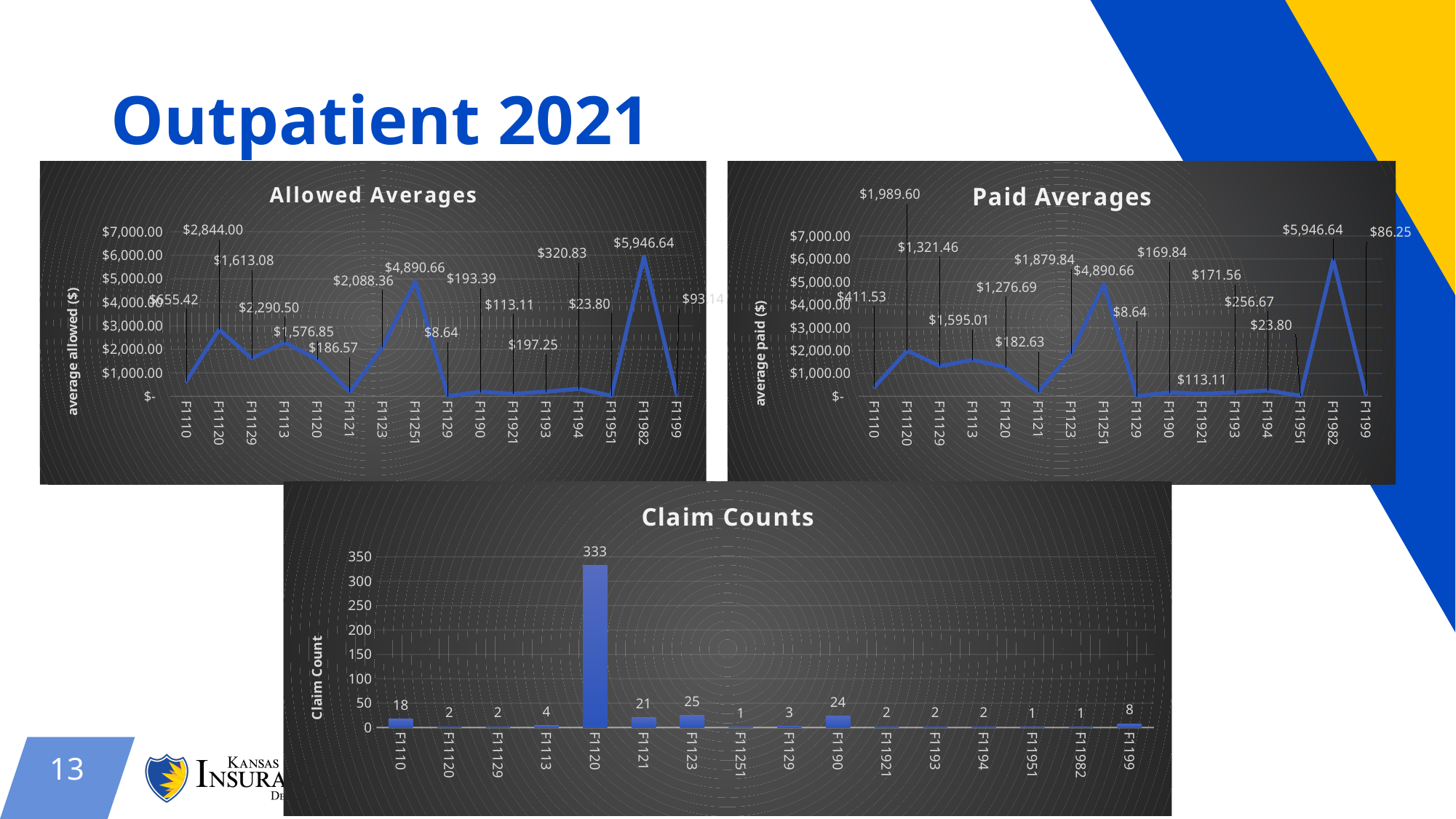
In the Claim Counts chart, what is the difference between the claim counts for F1121 and F1110? 3 How many categories are shown on the x axis of the Claim Counts chart? 16 What kind of chart is the Allowed Averages chart? line chart In the Paid Averages chart, which is larger, the value for F11251 or the value for F11982? F11982 In the Paid Averages chart, what is the average paid amount for F11120? $1,989.60 In the Allowed Averages chart, what is the average allowed amount for F1129? $8.64 In the Claim Counts chart, what is the claim count for F1123? 25 What kind of chart is the Claim Counts chart? bar chart In the Allowed Averages chart, what is the average allowed amount for F11251? $4,890.66 In the Claim Counts chart, which category has the highest claim count? F1120 In the Claim Counts chart, is the value for F1120 greater or less than 300? greater In the Allowed Averages chart, which category has the highest average allowed amount? F11982